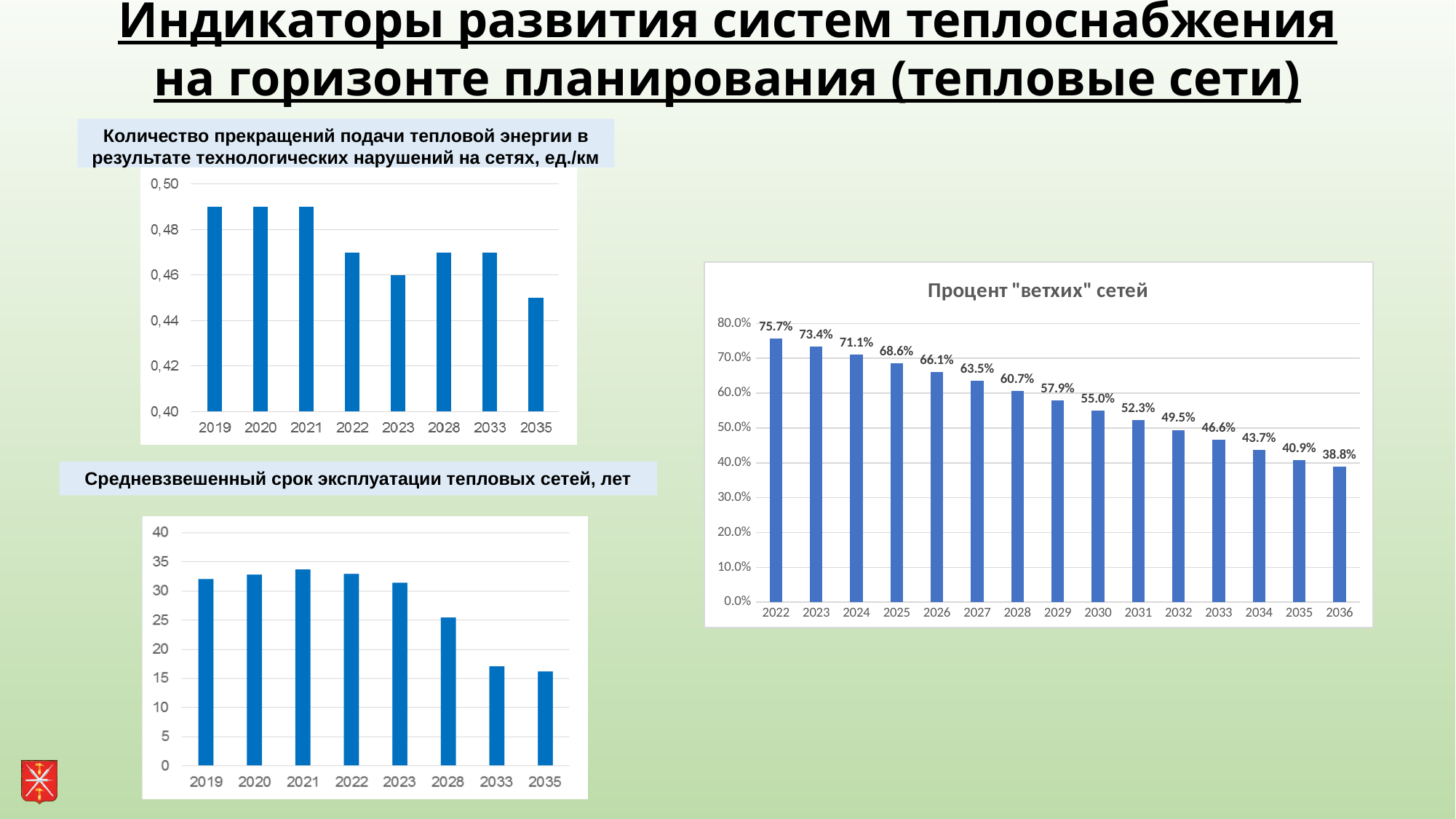
In the chart 'Процент "ветхих" сетей', which year has the lowest value? 2036 In the chart 'Процент "ветхих" сетей', how many years are shown on the x axis? 15 In the chart 'Средневзвешенный срок эксплуатации тепловых сетей, лет', which is larger, the value for 2028 or the value for 2035? 2028 In the chart 'Процент "ветхих" сетей', what is the value for 2030? 55.0% In the chart 'Количество прекращений подачи тепловой энергии в результате технологических нарушений на сетях, ед./км', is the value for 2035 greater or less than 0,46? less In the chart 'Процент "ветхих" сетей', do the values rise or fall from 2022 to 2036? fall In the chart 'Средневзвешенный срок эксплуатации тепловых сетей, лет', is the value for 2033 greater or less than 20? less In the chart 'Средневзвешенный срок эксплуатации тепловых сетей, лет', is the value for 2021 greater or less than 30? greater In the chart 'Процент "ветхих" сетей', what is the difference between the values for 2022 and 2036? 36.9% In the chart 'Процент "ветхих" сетей', what is the value for 2036? 38.8% What type of chart is the top-left chart on the slide? bar chart In the chart 'Процент "ветхих" сетей', what is the value for 2022? 75.7%